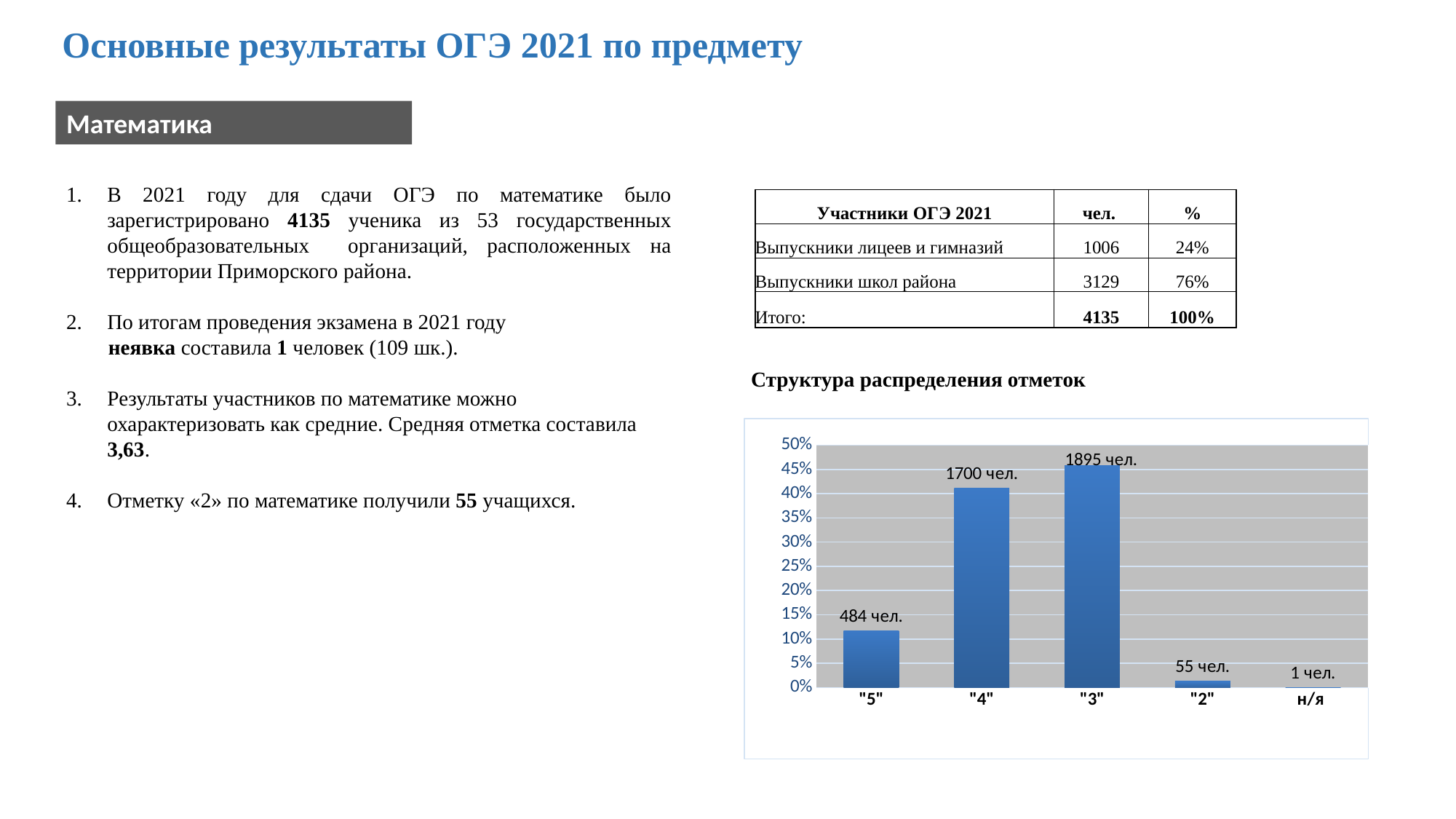
What is the data label for the "4" category in the chart? 1700 чел. Which category has the lowest bar in the chart? н/я Which is larger, the value for "5" or the value for "2"? "5" What is the data label for the "3" category in the chart? 1895 чел. Which category has the highest bar in the chart? "3" Is the value for "4" greater or less than 35%? greater By how many people does the "3" category exceed the "4" category? 195 чел. How many categories are shown on the x axis of the chart? 5 What type of chart is shown on the slide? bar chart What is the data label for the "5" category in the chart? 484 чел. What is the data label for the "2" category in the chart? 55 чел. Is the value for "5" greater or less than 10%? greater